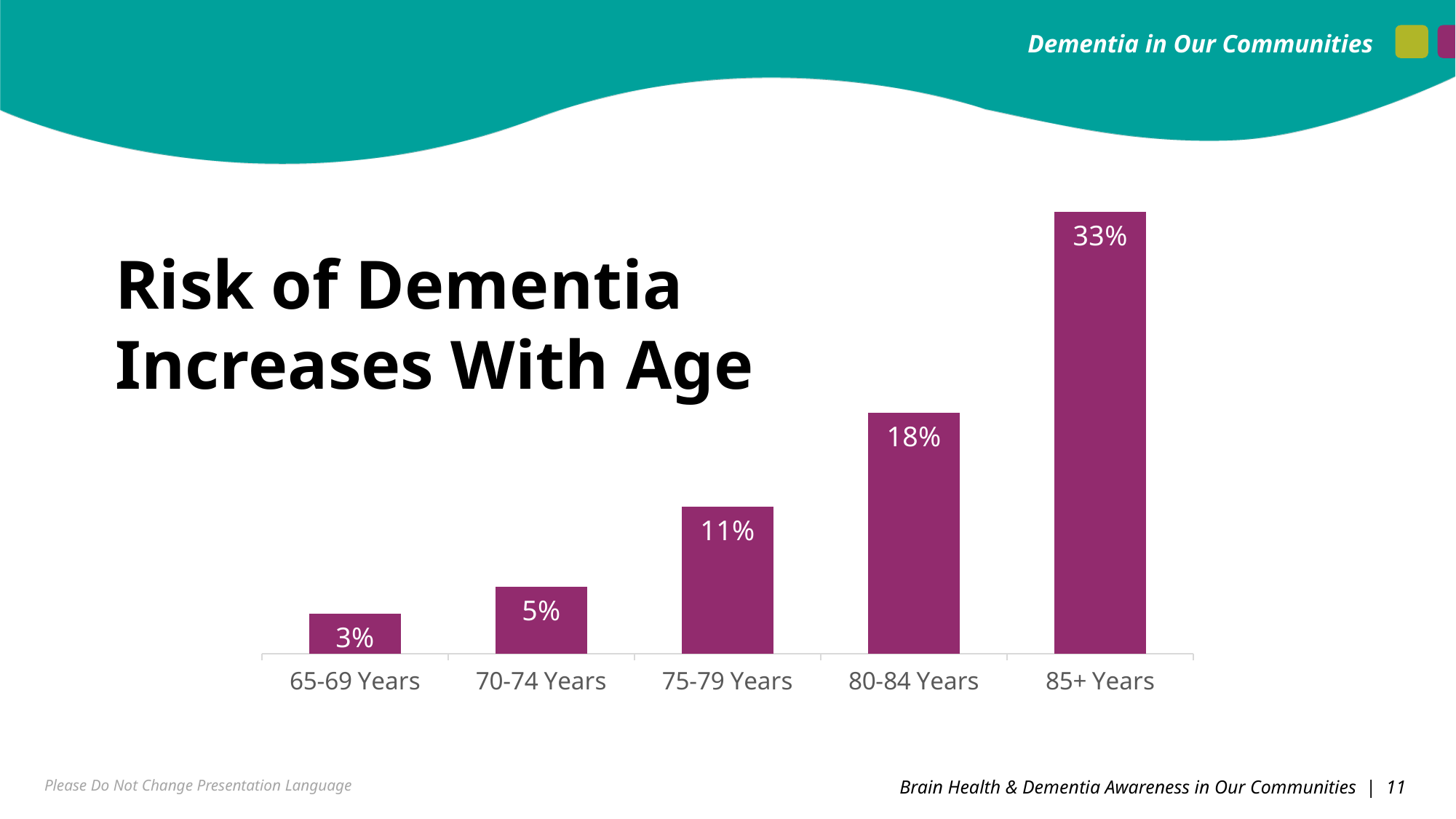
What is the value for 85+ Years? 33% What kind of chart is shown on the slide? Bar chart What is the value for 75-79 Years? 11% What is the value for 65-69 Years? 3% Do the values rise or fall as age increases along the x axis? Rise What is the difference between the values for 85+ Years and 80-84 Years? 15% What is the difference between the values for 75-79 Years and 70-74 Years? 6% Which age group has the lowest value? 65-69 Years Which age group has the highest value? 85+ Years What is the value for 80-84 Years? 18% Which is larger, the value for 70-74 Years or the value for 80-84 Years? 80-84 Years How many age groups are shown in the chart? 5